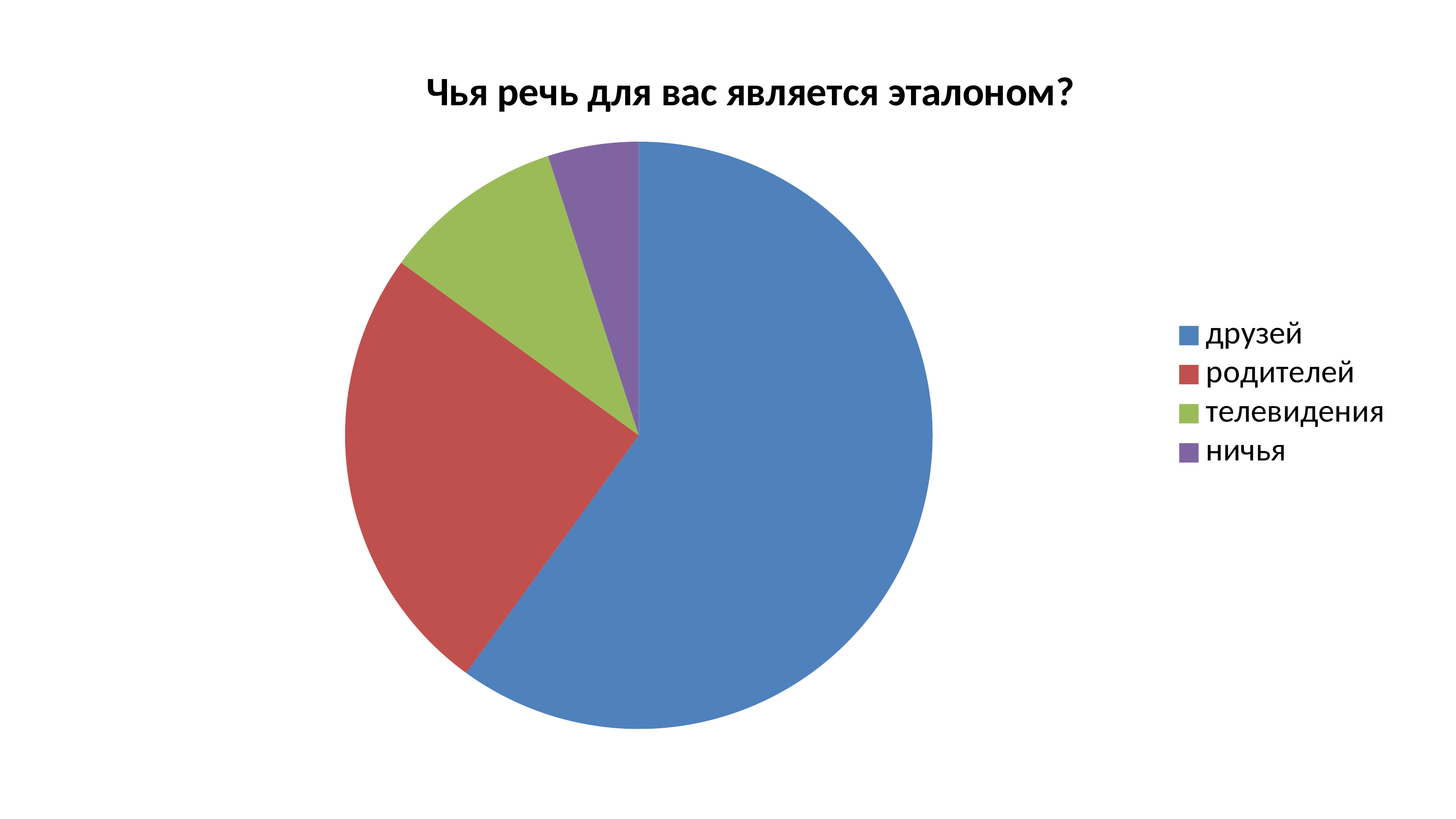
How many categories does the pie chart have? 4 Which category has the smallest slice of the pie? ничья Which slice is larger, телевидения or ничья? телевидения Which slice is larger, родителей or телевидения? родителей What kind of chart is shown on the slide? pie chart Which slice is larger, друзей or родителей? друзей What colour is the slice for родителей? red What is the title of the chart? Чья речь для вас является эталоном? Which category has the largest slice of the pie? друзей Does the slice for друзей take up more or less than half of the pie? more